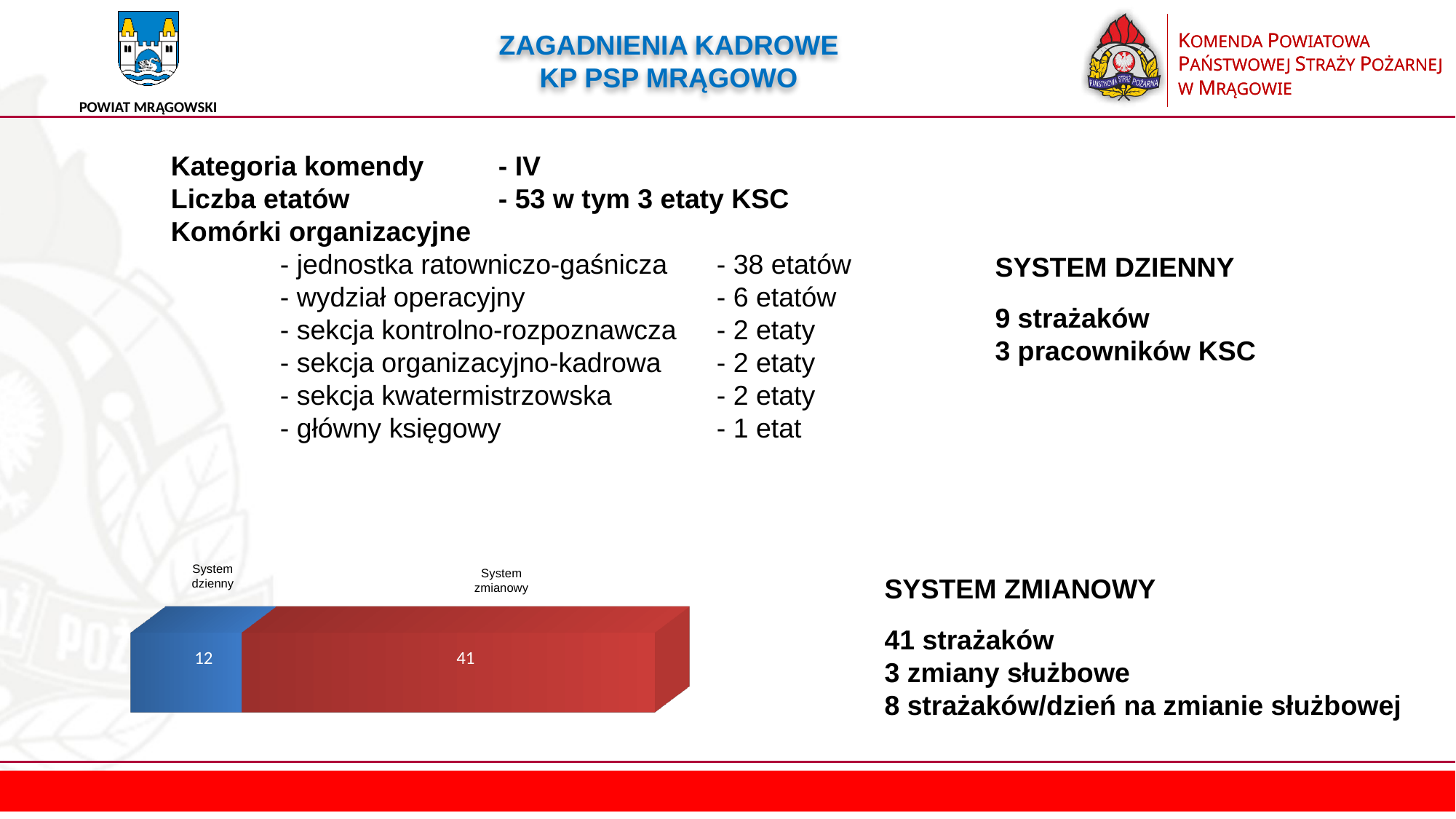
What is the total of the stacked bar in the chart? 53 What value is shown for System zmianowy in the chart? 41 Which category has the highest value in the chart? System zmianowy Which category has the lowest value in the chart? System dzienny How many segments does the stacked bar in the chart have? 2 What value is shown for System dzienny in the chart? 12 What colour is the System zmianowy segment of the bar? red What colour is the System dzienny segment of the bar? blue What is the difference between the values for System zmianowy and System dzienny? 29 What kind of chart is shown on the slide? bar chart Which segment of the chart is larger, System dzienny or System zmianowy? System zmianowy